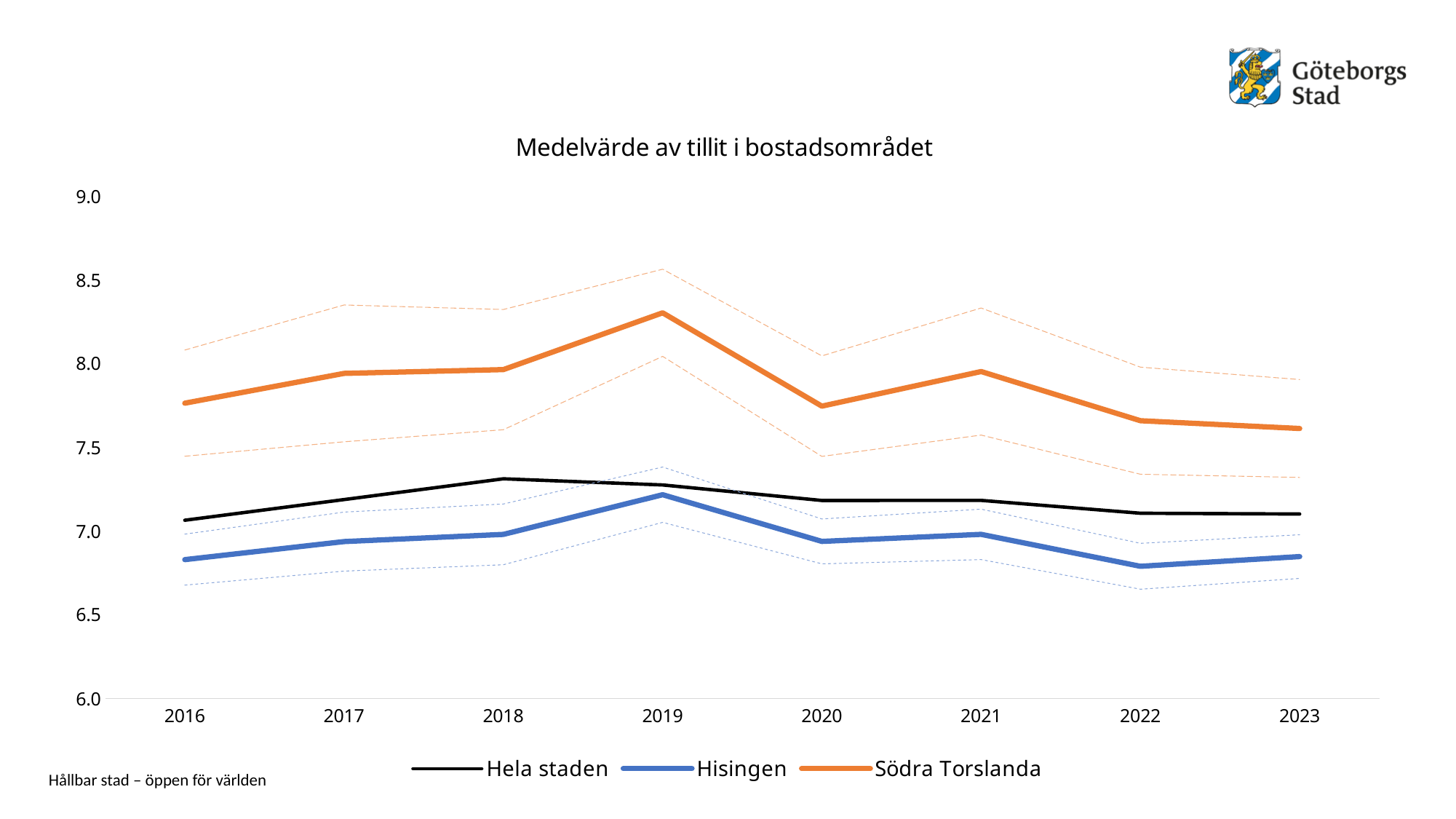
What is the title of the chart? Medelvärde av tillit i bostadsområdet In which year does Hisingen reach its highest value? 2019 Which series has the higher value in 2019, Södra Torslanda or Hisingen? Södra Torslanda How many years are shown on the x axis? 8 Is the value for Hela staden in 2018 greater or less than 7.0? greater Which series is drawn in orange? Södra Torslanda Is the value for Södra Torslanda in 2019 greater or less than 8.0? greater Is the value for Hisingen in 2016 greater or less than 7.0? less What kind of chart is shown on the slide? line chart In which year does Södra Torslanda reach its highest value? 2019 Does the Hisingen line rise or fall from 2019 to 2022? fall How many series does the legend list? 3